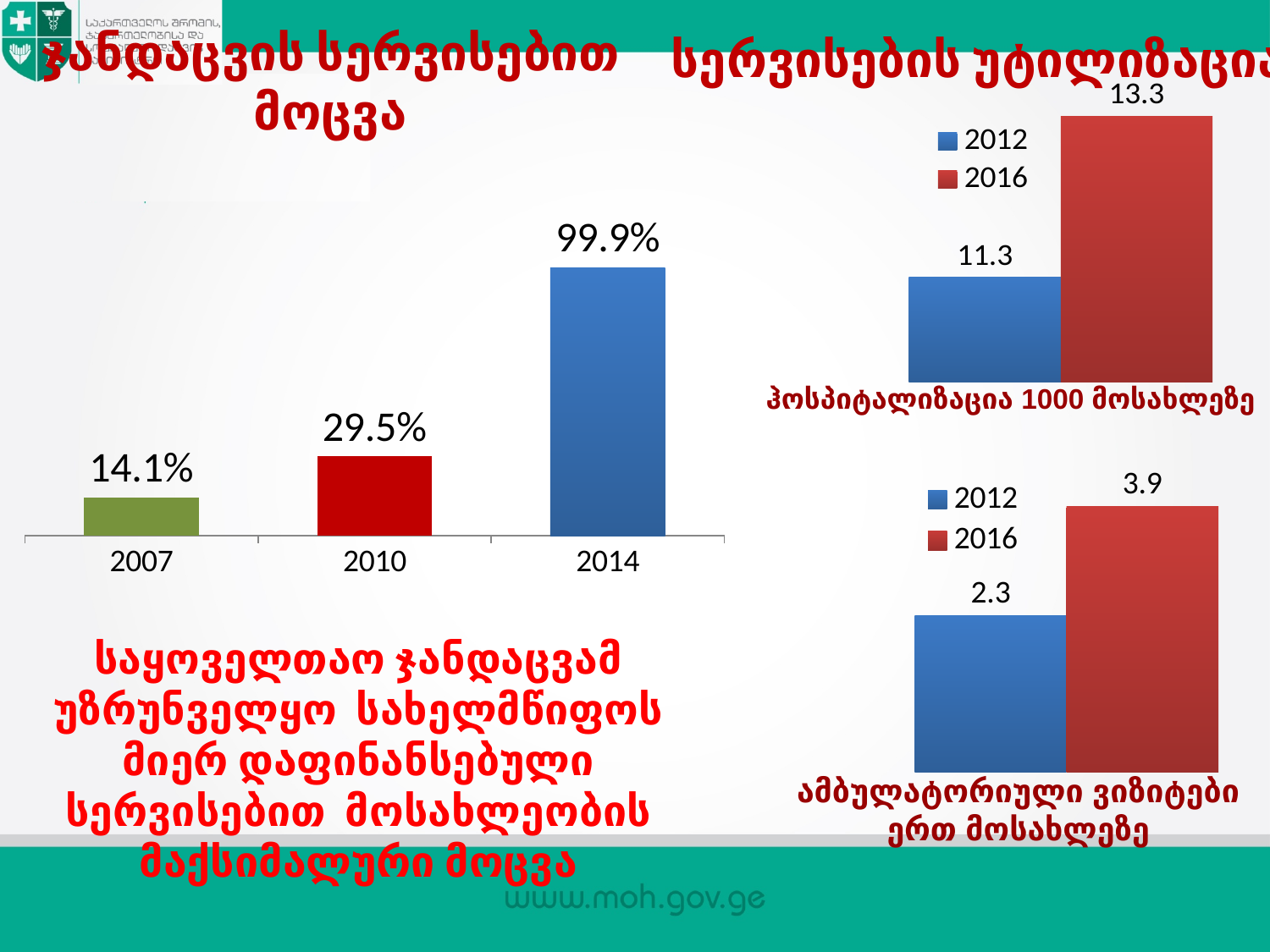
How many series does the legend of the top-right chart list? 2 How many bars are in the bar chart on the left of the slide? 3 In the top-right chart (hospitalization per 1000 population), what is the difference between the 2016 and 2012 values? 2.0 What kind of chart is the bottom-right chart on the slide? bar chart In the bar chart on the left of the slide, do the values rise or fall from 2007 to 2014? rise In the bottom-right chart (ambulatory visits per capita), what is the value for 2012? 2.3 In the top-right chart (hospitalization per 1000 population), what is the value for 2016? 13.3 In the bar chart on the left of the slide, which year has the lowest value? 2007 In the bar chart on the left of the slide, what is the value for 2014? 99.9% In the bar chart on the left of the slide, what is the value for 2007? 14.1% In the bar chart on the left of the slide, what is the difference between the 2010 and 2007 values? 15.4% In the bottom-right chart (ambulatory visits per capita), which year has the larger value, 2012 or 2016? 2016